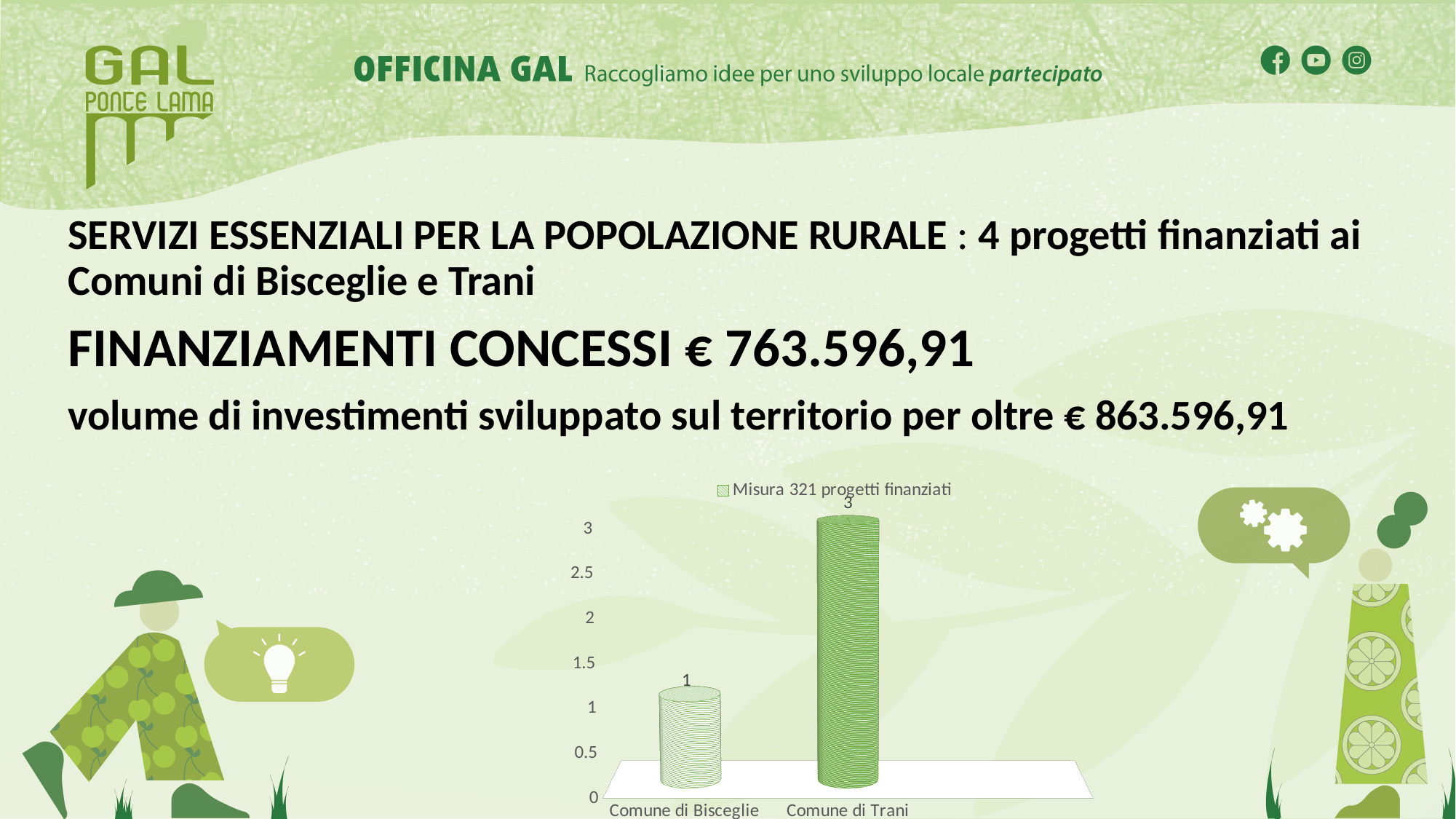
What is the value for Comune di Bisceglie in the chart? 1 Is the value for Comune di Trani greater or less than 2? greater Which category has the lowest value in the chart? Comune di Bisceglie Which is larger, the value for Comune di Bisceglie or the value for Comune di Trani? Comune di Trani How many categories are shown on the x axis of the chart? 2 What kind of chart is shown on the slide? bar chart Which category has the highest value in the chart? Comune di Trani What is the value for Comune di Trani in the chart? 3 What is the total of the values for Comune di Bisceglie and Comune di Trani? 4 How many series does the chart legend list? 1 What is the difference between the values for Comune di Trani and Comune di Bisceglie? 2 What is the name of the series shown in the chart legend? Misura 321 progetti finanziati